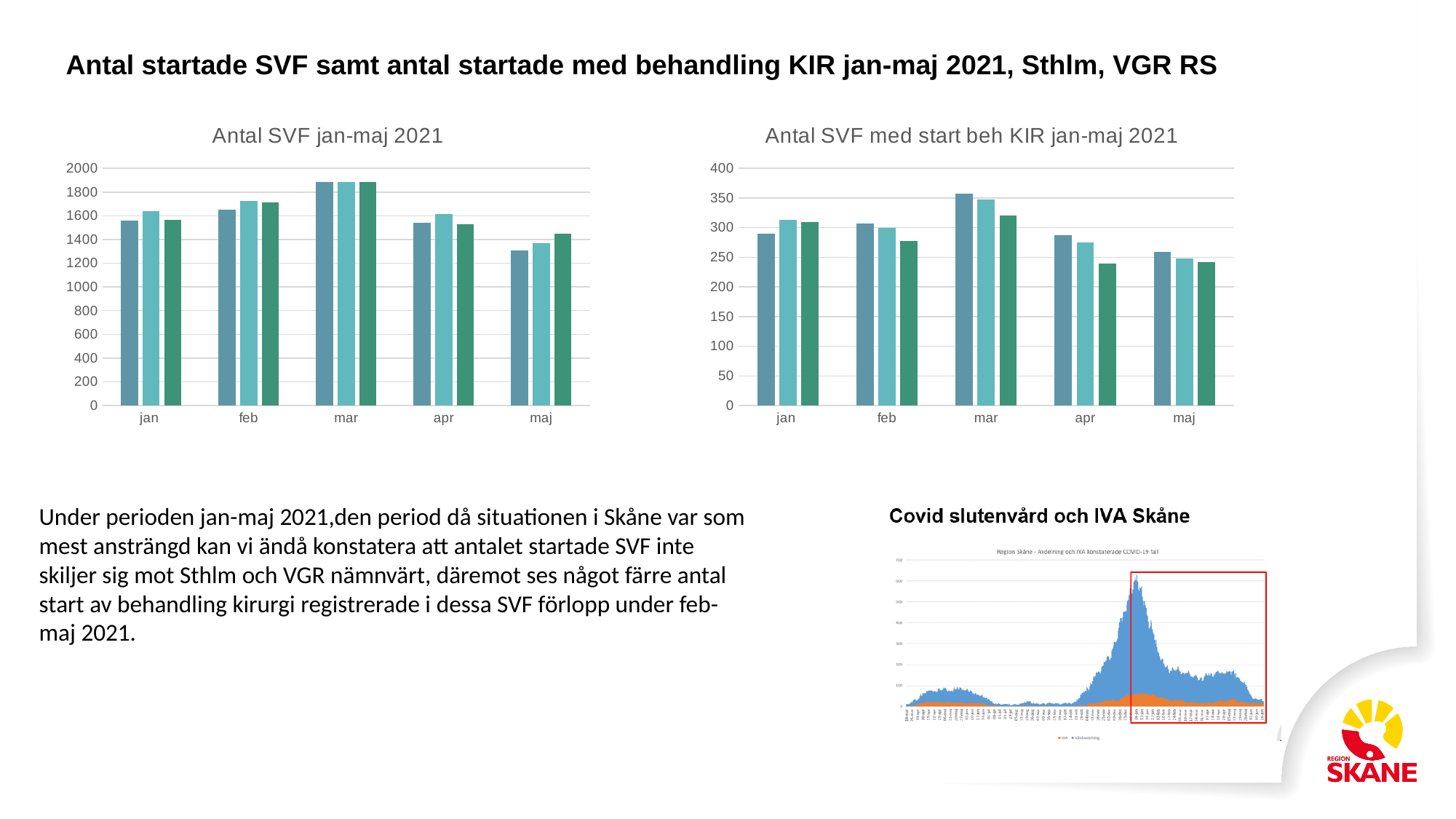
In the chart titled "Antal SVF jan-maj 2021", do the values rise or fall from mar to maj? fall In the chart titled "Antal SVF jan-maj 2021", is the first (leftmost) bar for maj greater or less than 1400? less In the chart titled "Antal SVF jan-maj 2021", are the values for mar greater or less than 1800? greater How many months are shown on the x axis of the chart titled "Antal SVF jan-maj 2021"? 5 In the chart titled "Antal SVF med start beh KIR jan-maj 2021", are the values for jan greater or less than 250? greater In the chart titled "Antal SVF med start beh KIR jan-maj 2021", which month has the tallest bars? mar In the chart titled "Antal SVF jan-maj 2021", how many bars are plotted for each month? 3 What is the title of the bar chart on the right side of the slide? Antal SVF med start beh KIR jan-maj 2021 What kind of chart is the chart titled "Antal SVF jan-maj 2021"? bar chart In the chart titled "Antal SVF jan-maj 2021", which month has the lowest bars? maj In the chart titled "Antal SVF jan-maj 2021", which month has the tallest bars? mar